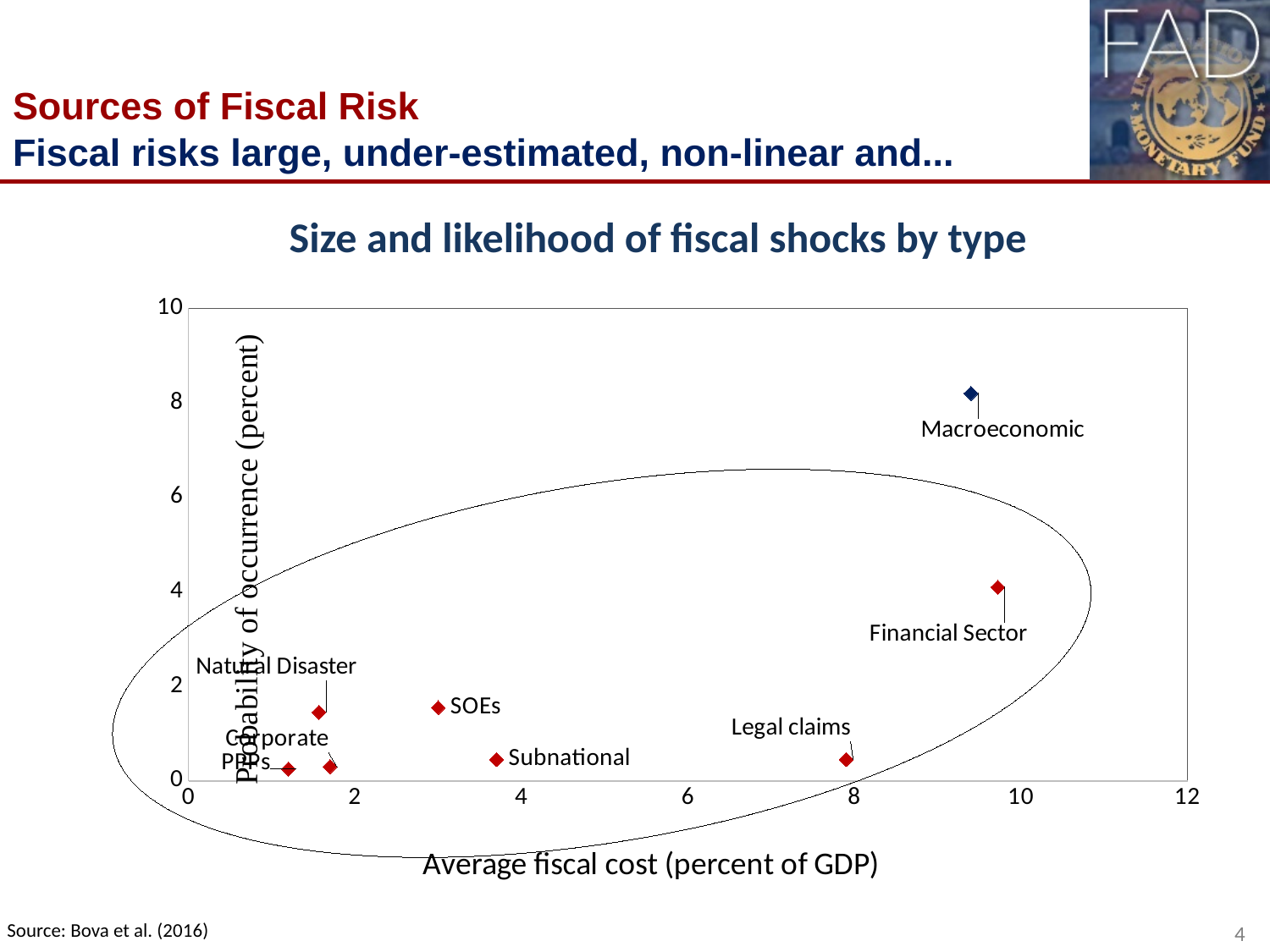
What kind of chart is shown on the slide? Scatter chart How many fiscal shock types are plotted on the chart? 8 Is the average fiscal cost for Legal claims greater or less than 6? greater Which fiscal shock type has the lowest average fiscal cost? PPPs Which has a higher probability of occurrence, Macroeconomic or Financial Sector? Macroeconomic Is the probability of occurrence for Macroeconomic greater or less than 6? greater Is the average fiscal cost for SOEs greater or less than 4? less Which fiscal shock type has the highest probability of occurrence? Macroeconomic Which has a higher probability of occurrence, SOEs or Subnational? SOEs What is the label of the x axis? Average fiscal cost (percent of GDP) What is the title of the chart? Size and likelihood of fiscal shocks by type Which has a higher average fiscal cost, Legal claims or SOEs? Legal claims